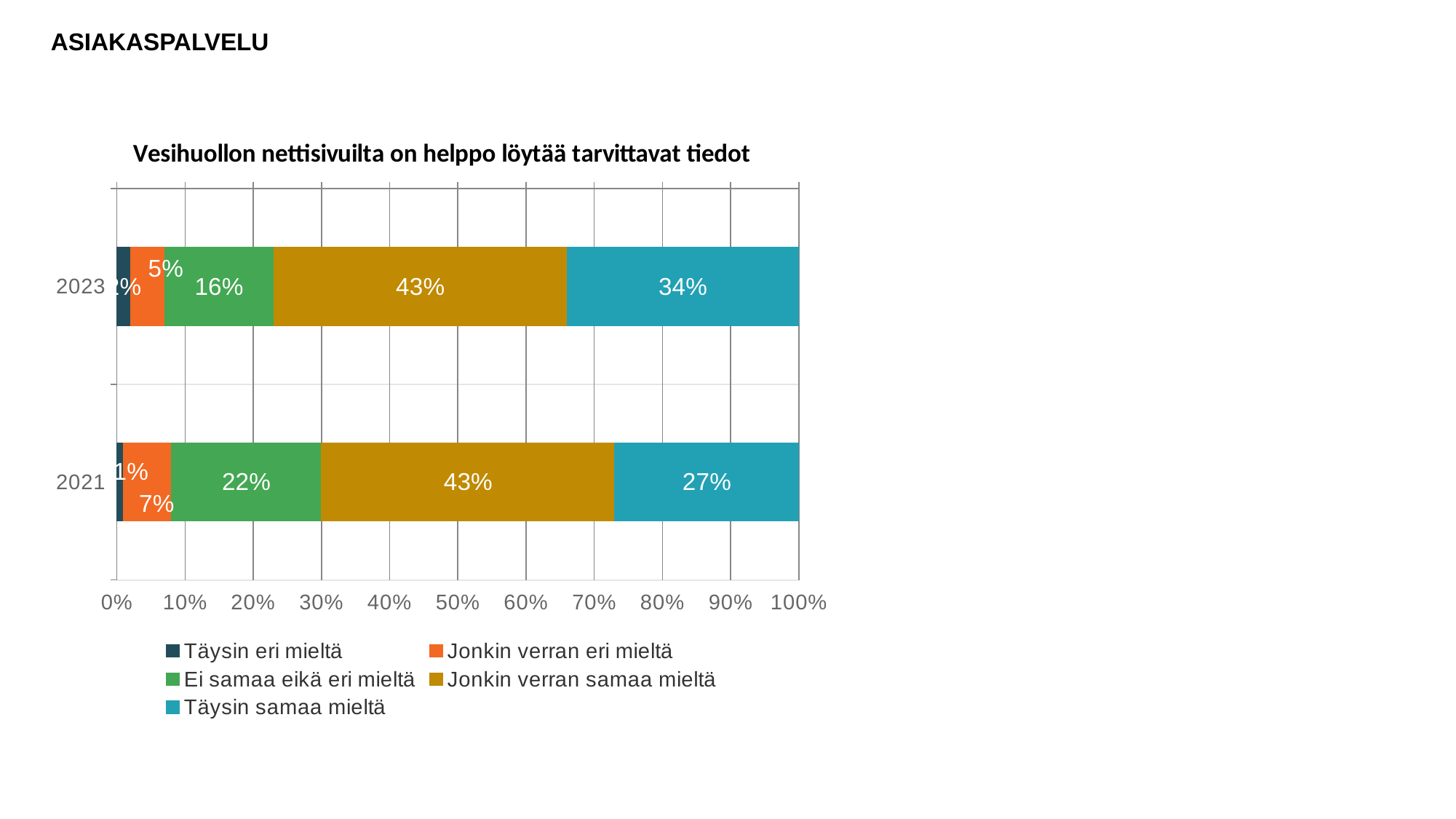
What is the value for 'Jonkin verran samaa mieltä' in 2021? 43% What is the value for 'Ei samaa eikä eri mieltä' in 2021? 22% What kind of chart is shown on the slide? Stacked bar chart What is the value for 'Täysin samaa mieltä' in 2023? 34% What is the chart's title? Vesihuollon nettisivuilta on helppo löytää tarvittavat tiedot What is the value for 'Jonkin verran eri mieltä' in 2023? 5% How many years (categories) are shown on the vertical axis? 2 What is the value for 'Täysin samaa mieltä' in 2021? 27% What is the difference between the 'Täysin samaa mieltä' values for 2023 and 2021? 7% How many series does the legend list? 5 Which series has the largest share in the 2023 bar? Jonkin verran samaa mieltä Which is larger: 'Ei samaa eikä eri mieltä' in 2021 or in 2023? 2021